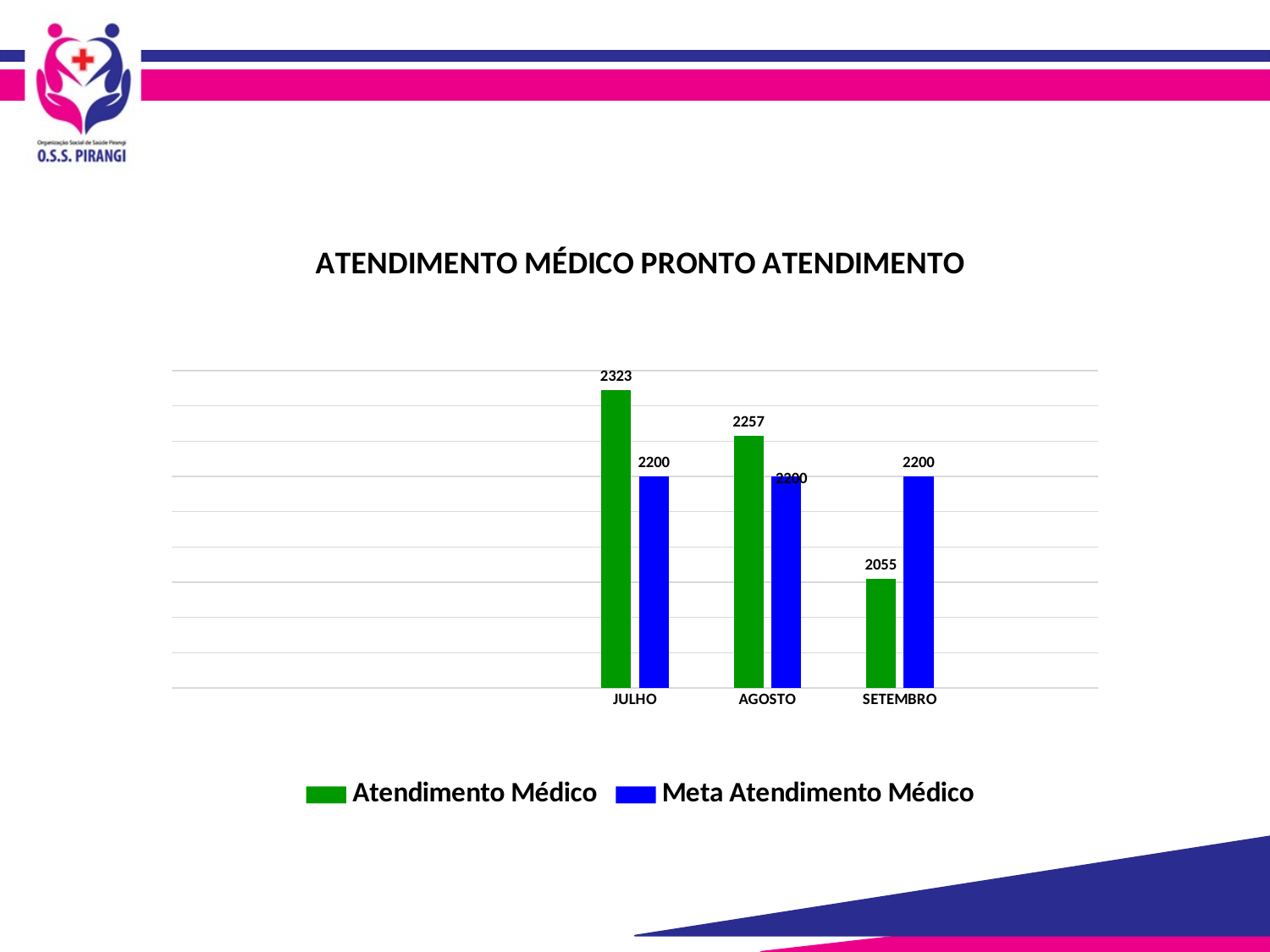
What is the value of Atendimento Médico for AGOSTO? 2257 How many months are shown on the x axis? 3 Which is larger in SETEMBRO: Atendimento Médico or Meta Atendimento Médico? Meta Atendimento Médico What kind of chart is shown on the slide? Bar chart What is the value of Atendimento Médico for SETEMBRO? 2055 How many series does the legend list? 2 Which month has the highest Atendimento Médico value? JULHO Which month has the lowest Atendimento Médico value? SETEMBRO What is the value of Atendimento Médico for JULHO? 2323 What is the value of Meta Atendimento Médico for JULHO? 2200 What is the difference between Atendimento Médico in JULHO and in SETEMBRO? 268 What is the difference between Atendimento Médico in JULHO and the Meta Atendimento Médico in JULHO? 123